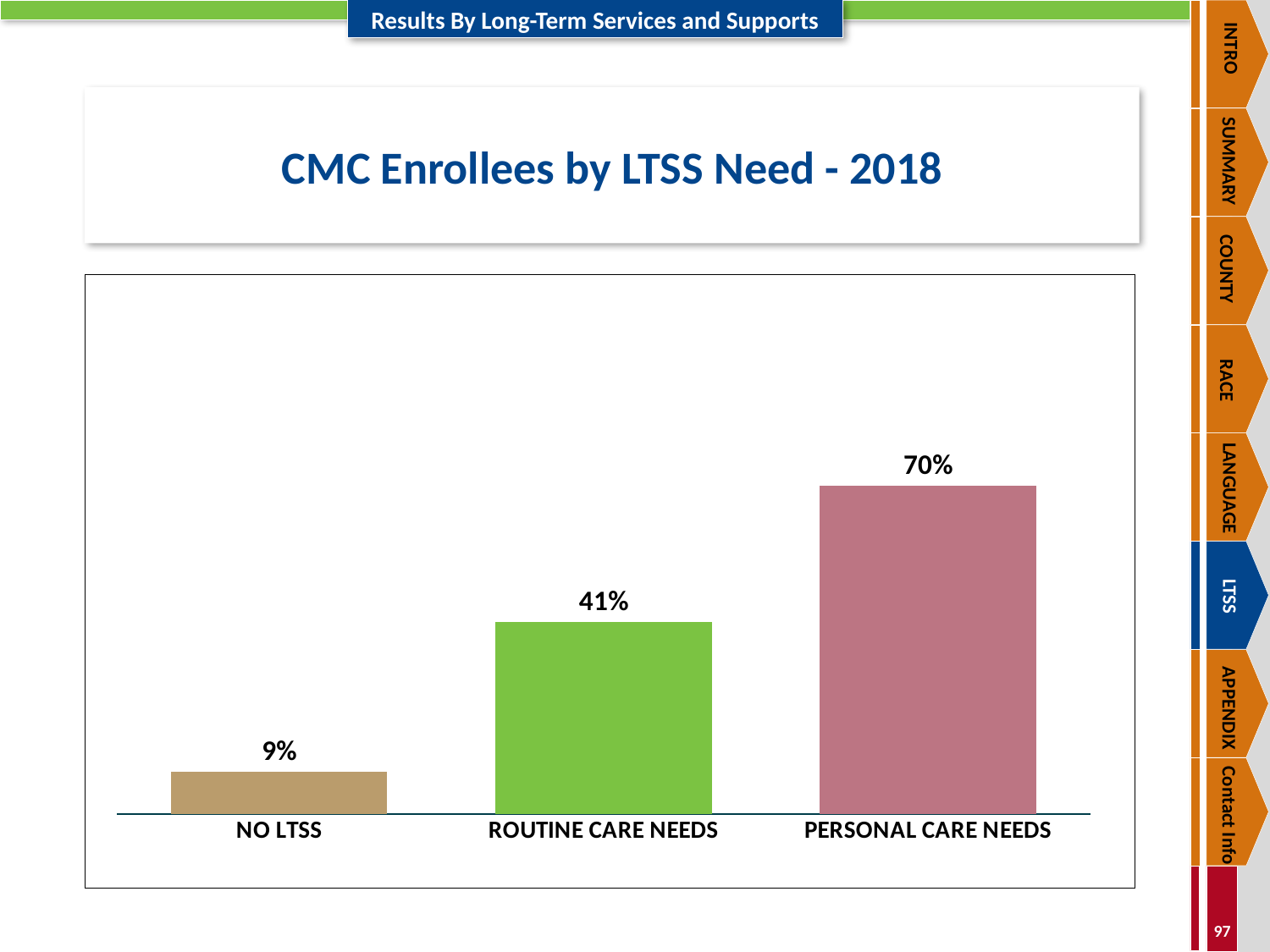
How many categories are shown in the chart? 3 What is the difference between the values for ROUTINE CARE NEEDS and NO LTSS? 32% Which is larger, the value for ROUTINE CARE NEEDS or the value for NO LTSS? ROUTINE CARE NEEDS What is the title of the chart? CMC Enrollees by LTSS Need - 2018 What is the value for ROUTINE CARE NEEDS? 41% Which category has the lowest value? NO LTSS Do the values rise or fall from left to right across the categories? Rise What kind of chart is shown on the slide? Bar chart Which category has the highest value? PERSONAL CARE NEEDS What is the difference between the values for PERSONAL CARE NEEDS and ROUTINE CARE NEEDS? 29% What is the value for NO LTSS? 9% What is the value for PERSONAL CARE NEEDS? 70%